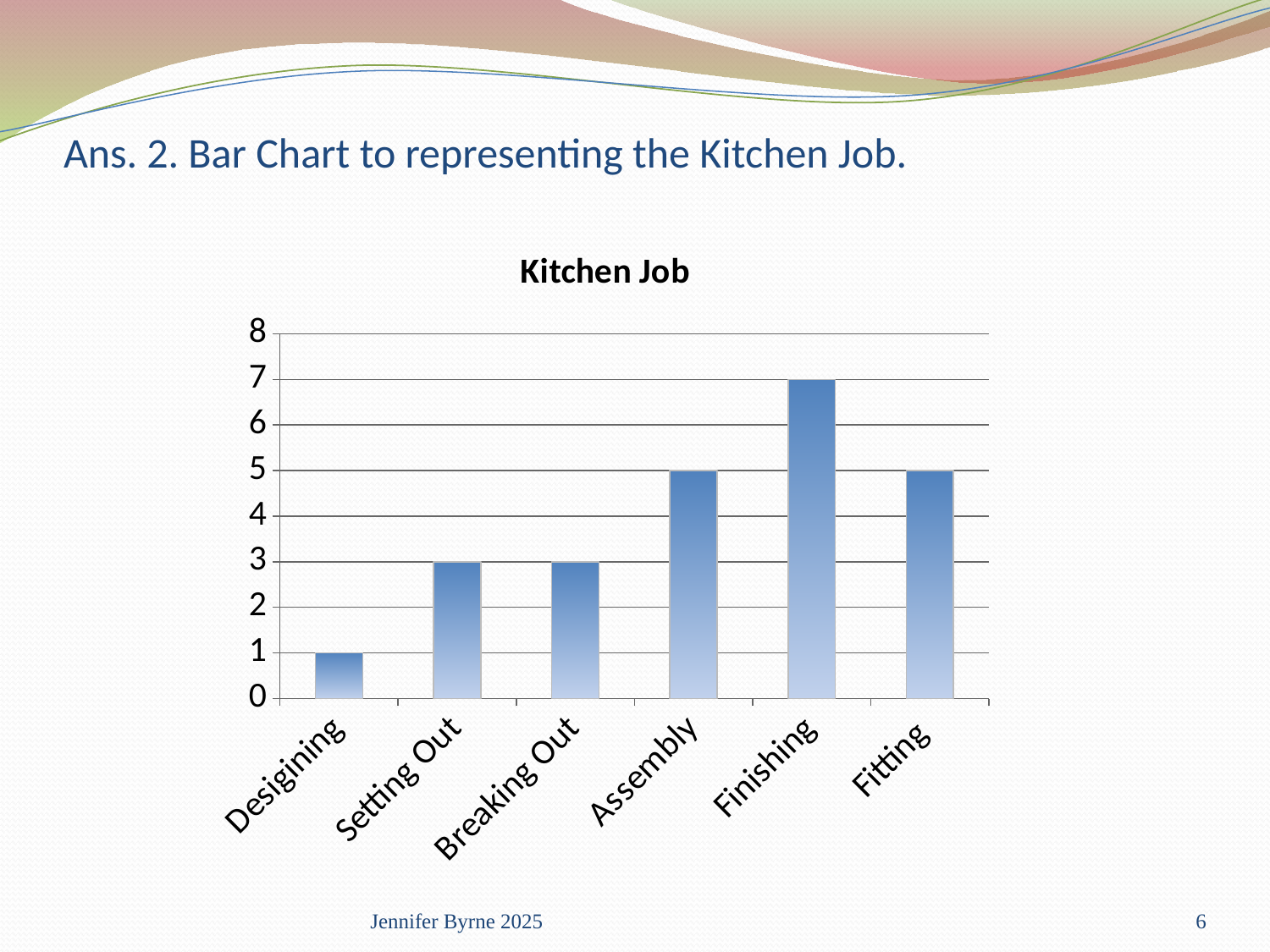
Which is larger in the Kitchen Job chart, the value for Fitting or the value for Setting Out? Fitting Which category has the lowest value in the Kitchen Job chart? Desigining Which category has the highest value in the Kitchen Job chart? Finishing What is the value for Desigining in the Kitchen Job chart? 1 Is the value for Assembly in the Kitchen Job chart greater or less than 4? greater What type of chart is shown on the slide? Bar chart What is the value for Assembly in the Kitchen Job chart? 5 How many categories are shown on the x axis of the Kitchen Job chart? 6 What is the value for Setting Out in the Kitchen Job chart? 3 What is the title of the chart? Kitchen Job What is the value for Finishing in the Kitchen Job chart? 7 What is the difference between the values for Finishing and Breaking Out in the Kitchen Job chart? 4